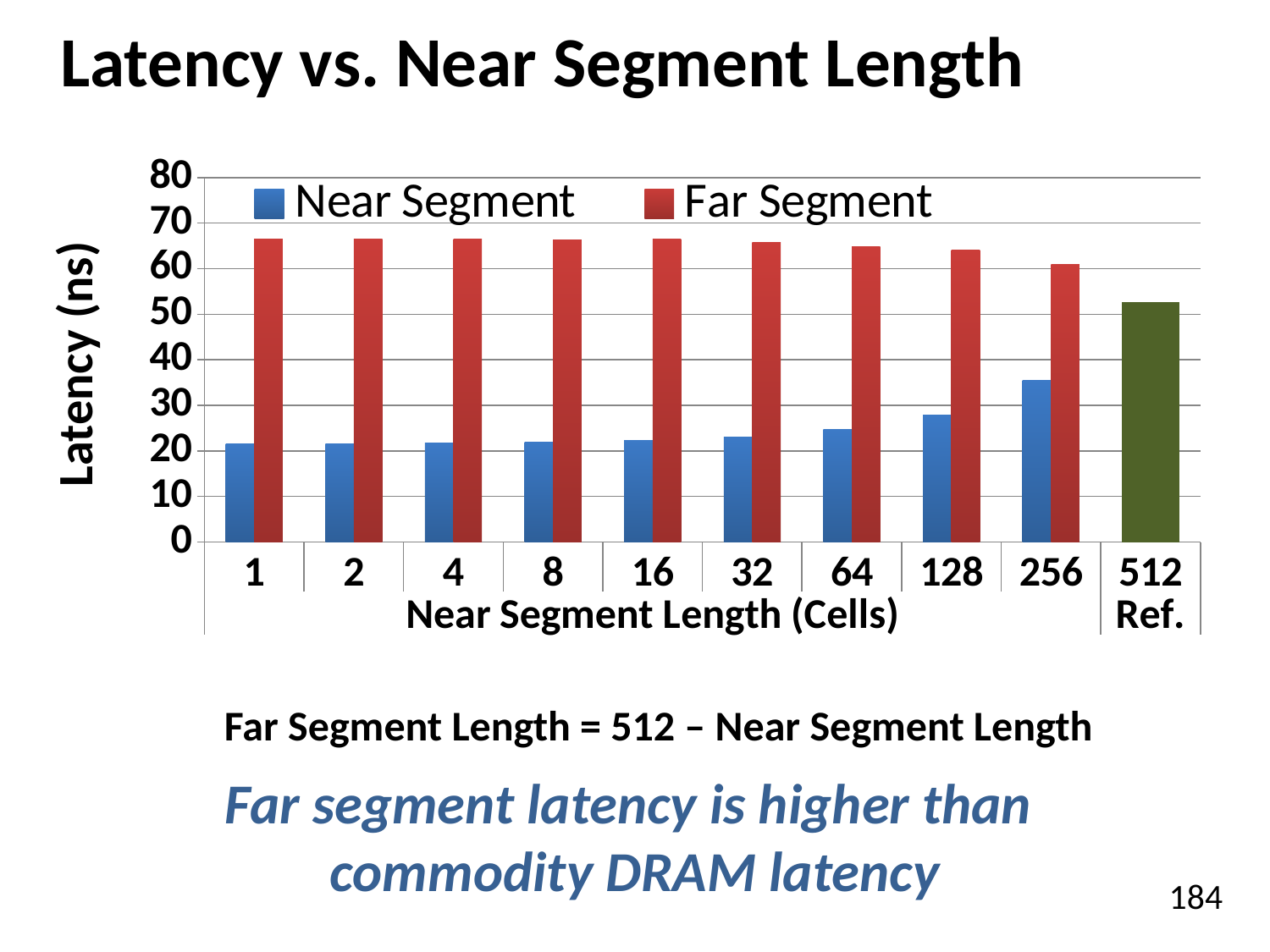
How many series does the legend list? 2 Is the value for 512 Ref. greater or less than 60? less Is the Near Segment value at near segment length 256 greater or less than 30? greater What is the title of the y axis? Latency (ns) At which near segment length is the Far Segment latency lowest? 256 Do the Far Segment values rise or fall as the near segment length increases from 1 to 256? fall Is the Far Segment value at near segment length 1 greater or less than 60? greater How many categories are shown along the x axis? 10 What kind of chart is shown on the slide? bar chart Do the Near Segment values rise or fall as the near segment length increases from 1 to 256? rise At which near segment length is the Near Segment latency highest? 256 Which is larger: the Far Segment value at near segment length 256 or the 512 Ref. value? Far Segment at 256